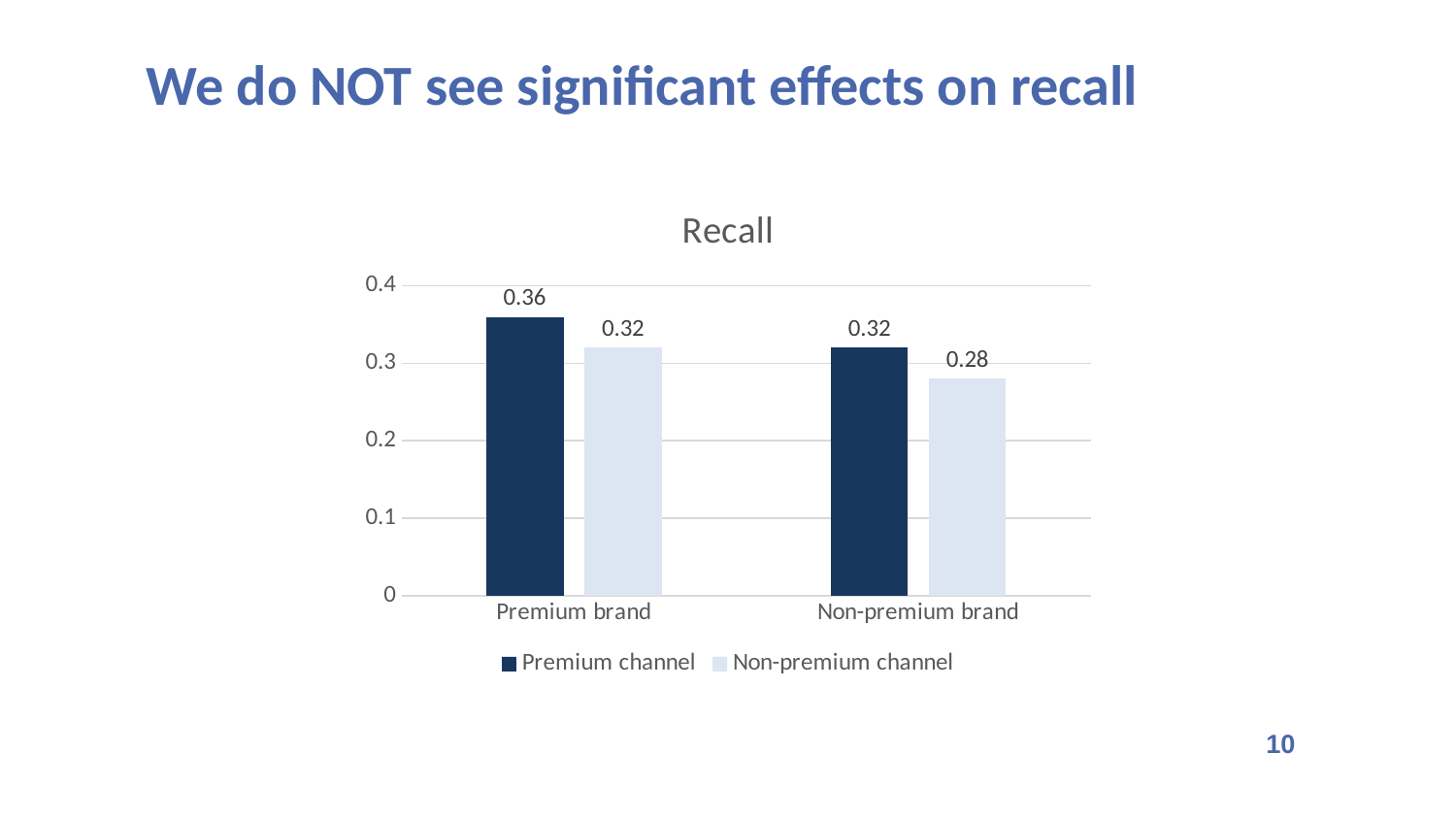
How many brand categories are shown on the x axis? 2 What is the difference between the Premium channel and Non-premium channel values for Premium brand? 0.04 What is the recall value for Premium brand in the Premium channel series? 0.36 How many series does the legend list? 2 What is the recall value for Premium brand in the Non-premium channel series? 0.32 Which brand category has the highest recall value in the Premium channel series? Premium brand What is the recall value for Non-premium brand in the Premium channel series? 0.32 Which brand category has the lowest recall value in the Non-premium channel series? Non-premium brand Which is larger: the Premium channel value for Non-premium brand or the Non-premium channel value for Non-premium brand? Premium channel What type of chart is shown on the slide? Bar chart What is the difference between the Premium channel values for Premium brand and Non-premium brand? 0.04 What is the recall value for Non-premium brand in the Non-premium channel series? 0.28